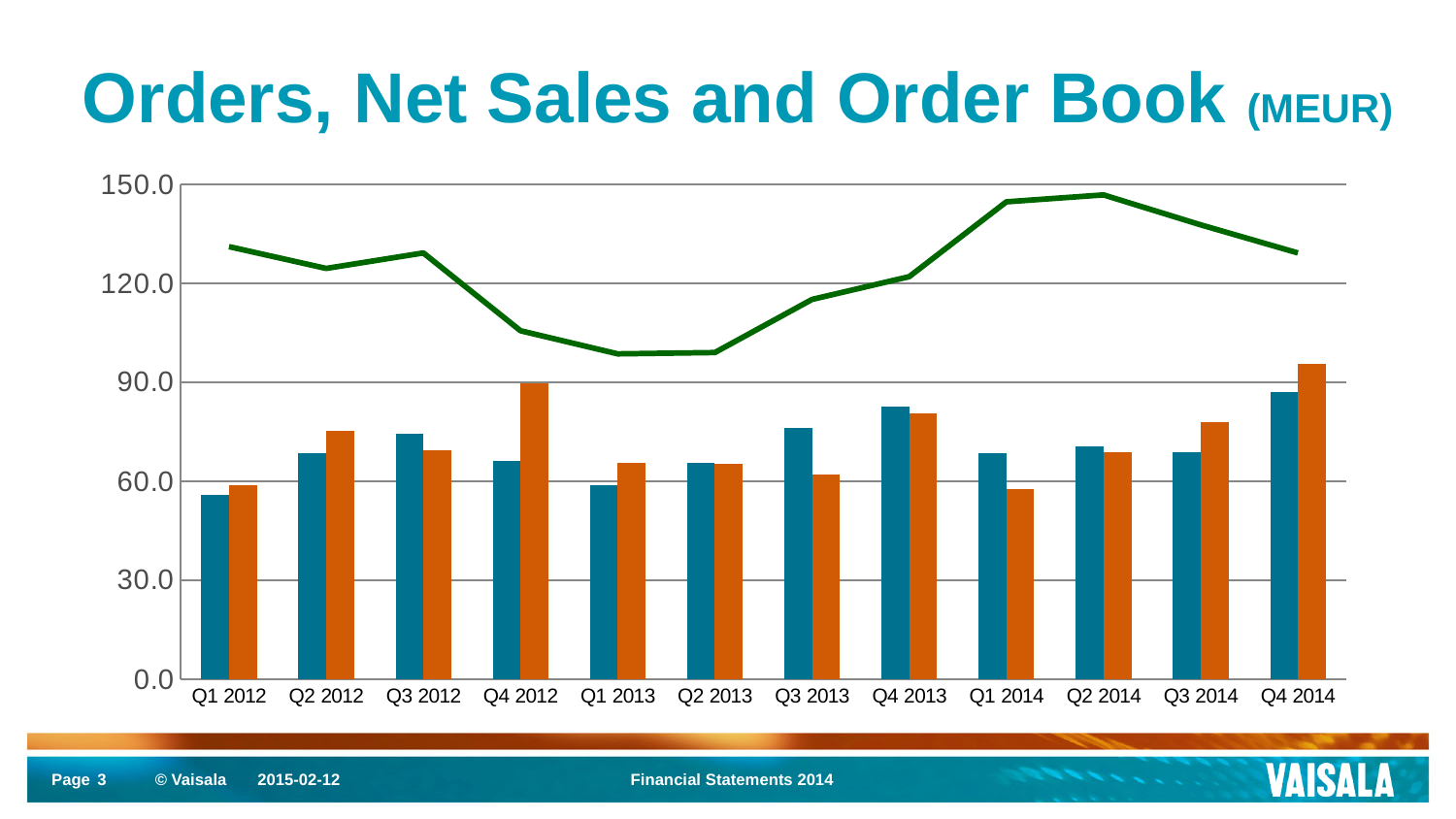
Does the green line rise or fall from Q1 2012 to Q1 2013? Fall Is the value of the blue bar for Q4 2013 greater or less than 60? greater Is the value of the blue bar for Q1 2012 greater or less than 60? less Is the value of the green line for Q2 2014 greater or less than 120? greater How many quarters are shown on the x axis? 12 In which quarter is the orange bar the highest? Q4 2014 For Q3 2013, which is larger, the blue bar or the orange bar? The blue bar What kind of chart is shown on the slide? Combined bar and line chart For Q4 2012, which is larger, the blue bar or the orange bar? The orange bar What is the highest value shown on the y axis? 150.0 What is the title of the chart? Orders, Net Sales and Order Book (MEUR)